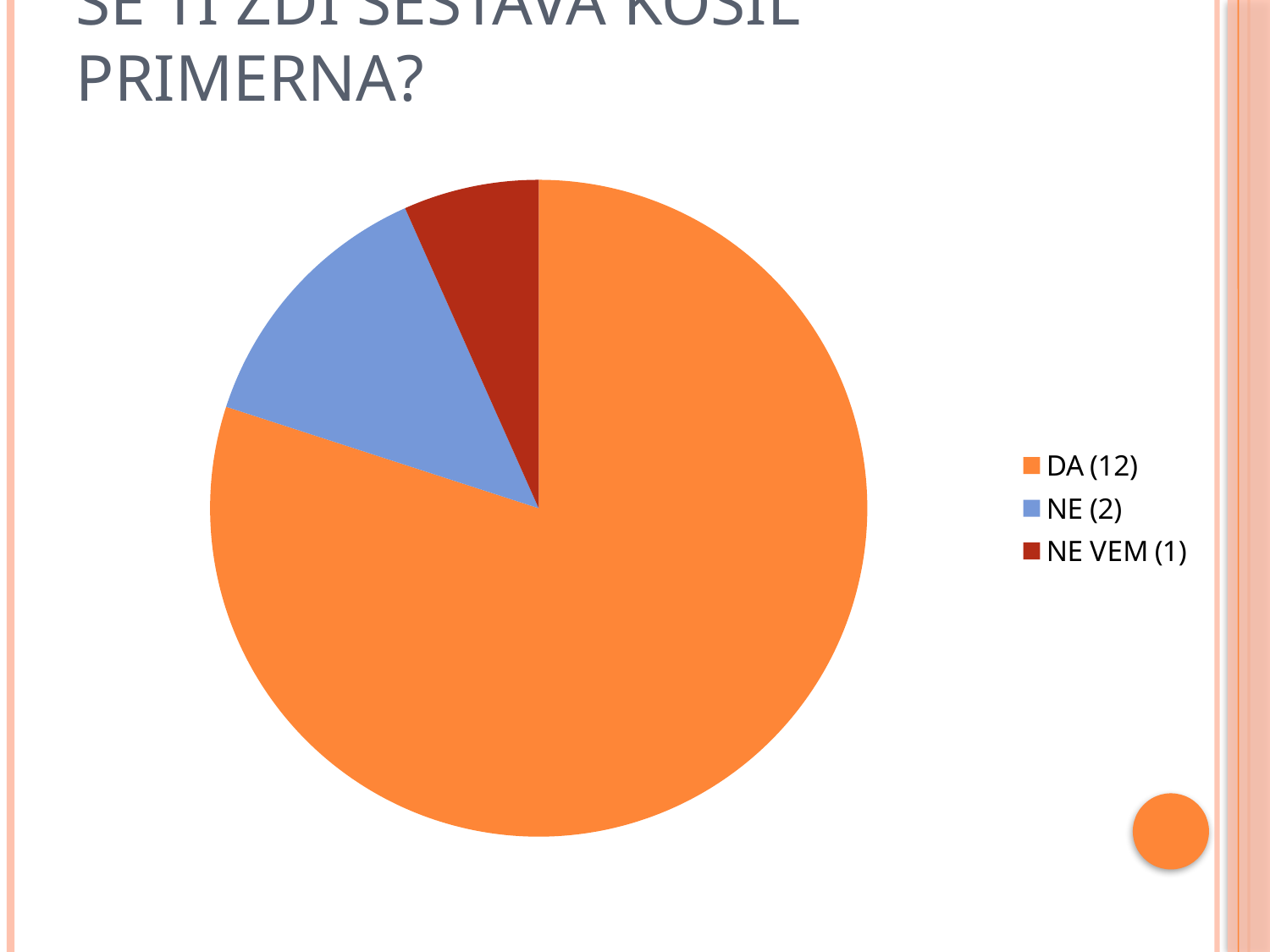
What share of the pie does the DA slice represent? 80% What is the value for DA in the pie chart? 12 What kind of chart is shown on the slide? pie chart What is the value for NE in the pie chart? 2 What colour is the DA slice in the pie chart? orange Which category has the smallest slice of the pie chart? NE VEM What is the total of all values shown in the pie chart? 15 What is the value for NE VEM in the pie chart? 1 What is the difference between the values for DA and NE? 10 Which category has the largest slice of the pie chart? DA How many slices does the pie chart have? 3 Which is larger, the value for NE or the value for NE VEM? NE